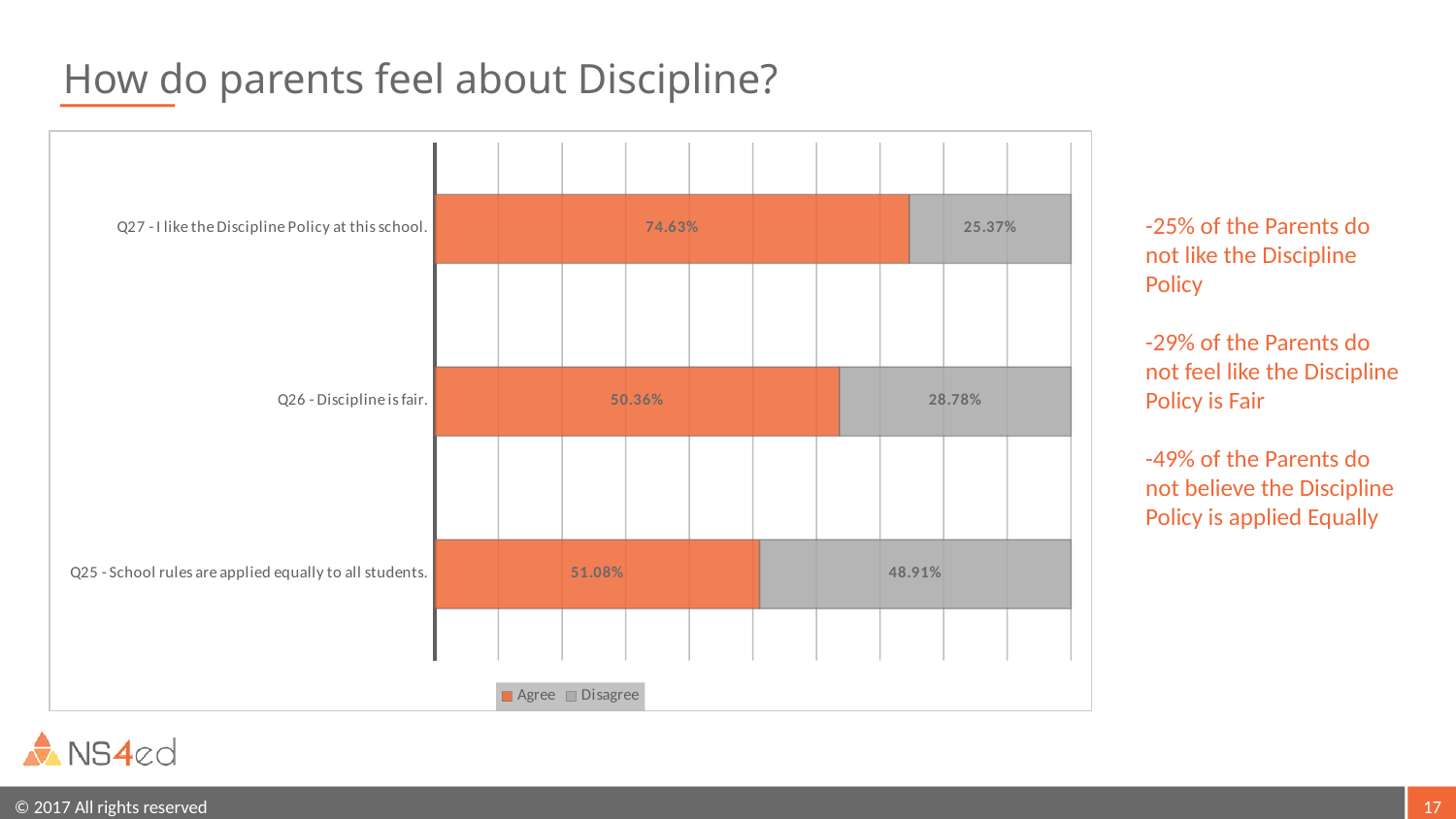
How many questions (categories) are shown in the chart? 3 Which question has the highest Agree percentage? Q27 - I like the Discipline Policy at this school. What is the difference between the Agree and Disagree values for Q27 - I like the Discipline Policy at this school? 49.26% Is the Agree value larger for Q27 - I like the Discipline Policy at this school or for Q26 - Discipline is fair? Q27 - I like the Discipline Policy at this school. Which question has the lowest Disagree percentage? Q27 - I like the Discipline Policy at this school. What is the total of the Agree and Disagree values for Q26 - Discipline is fair? 79.14% How many series does the legend list? 2 What percentage of parents agree with Q27 - I like the Discipline Policy at this school? 74.63% What type of chart is shown on the slide? Stacked bar chart What is the Disagree value for Q26 - Discipline is fair? 28.78% What is the Agree value for Q25 - School rules are applied equally to all students? 51.08% Which question has the highest Disagree percentage? Q25 - School rules are applied equally to all students.